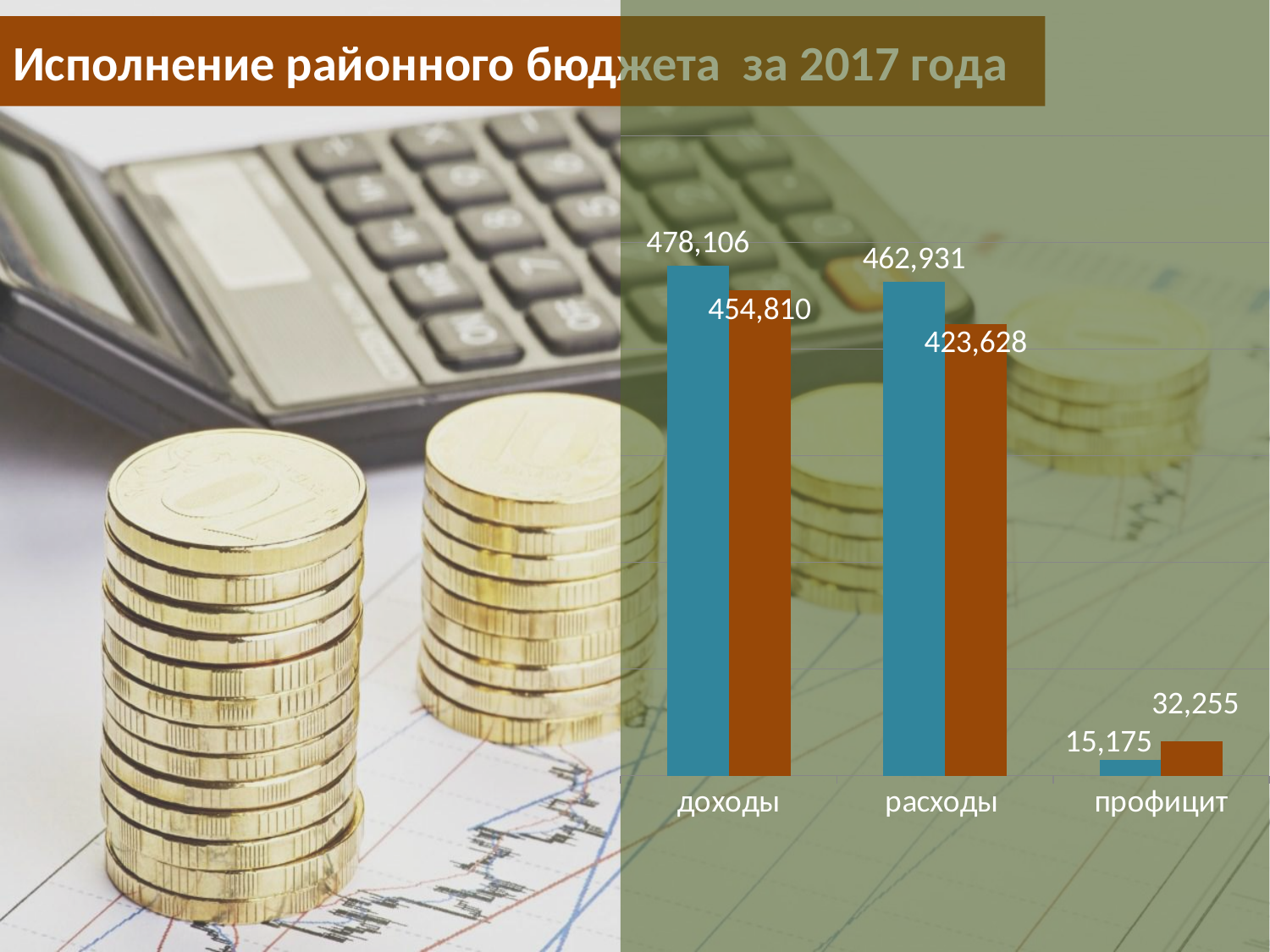
What is the value of the blue bar for доходы? 478,106 What type of chart is shown on the slide? bar chart For профицит, which bar is larger, the blue or the orange one? orange What is the difference between the blue and orange bars for доходы? 23,296 Which category has the highest blue bar? доходы Which category has the lowest values in the chart? профицит What is the value of the blue bar for профицит? 15,175 What is the value of the orange bar for расходы? 423,628 What is the value of the orange bar for доходы? 454,810 What is the value of the blue bar for расходы? 462,931 How many categories are shown on the x axis of the chart? 3 What is the value of the orange bar for профицит? 32,255